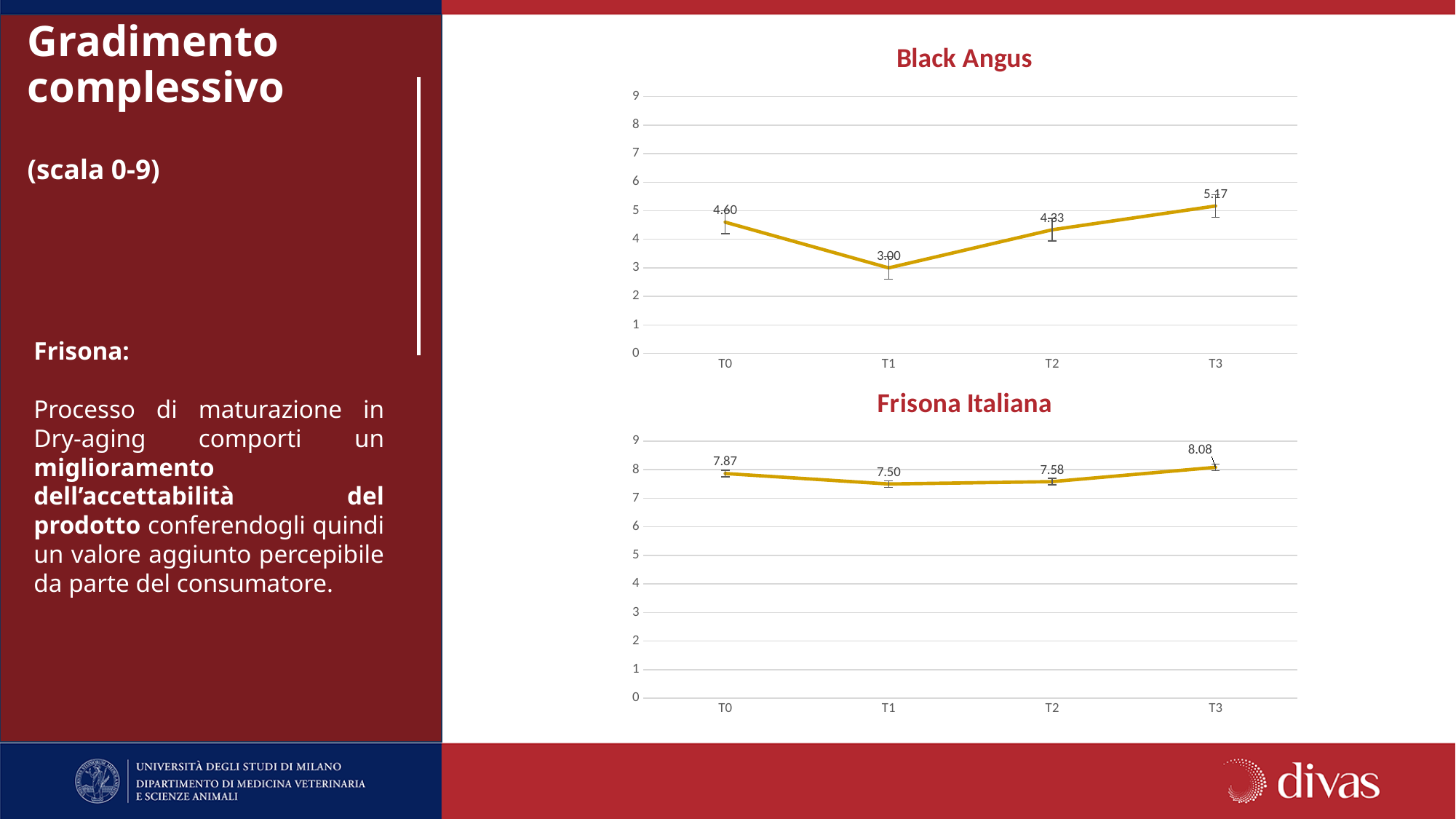
In the Frisona Italiana chart, what is the difference between the values at T0 and T1? 0.37 In the Black Angus chart, does the value rise or fall from T1 to T3? rise In the Black Angus chart, which is larger, the value at T0 or the value at T2? T0 In the Frisona Italiana chart, what is the value at T3? 8.08 In the Black Angus chart, what is the difference between the values at T3 and T1? 2.17 In the Frisona Italiana chart, is the value at T2 greater or less than 7? greater How many time points are plotted in the Black Angus chart? 4 What kind of chart is the Frisona Italiana chart? line chart What is the title of the top chart on the slide? Black Angus In the Black Angus chart, which time point has the highest value? T3 In the Black Angus chart, what is the value at T1? 3.00 In the Frisona Italiana chart, which time point has the lowest value? T1